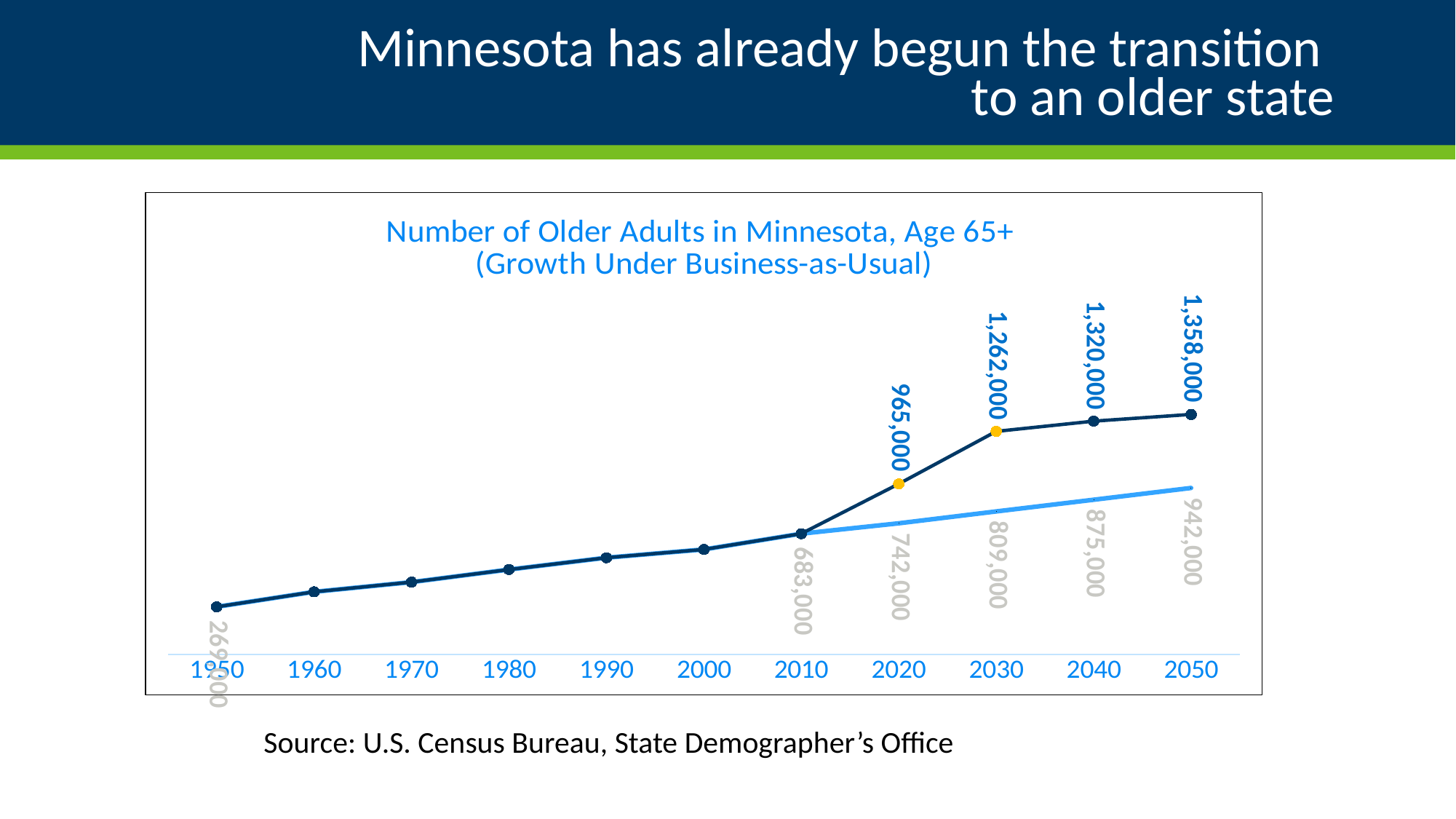
What is the number of older adults in Minnesota in 2010? 683,000 What value does the lower light blue line show for 2020? 742,000 What value does the lower light blue line show for 2050? 942,000 What value does the upper dark blue line show for 2050? 1,358,000 What is the chart's title? Number of Older Adults in Minnesota, Age 65+ (Growth Under Business-as-Usual) What is the number of older adults in Minnesota in 1950? 269,000 In 2020, how much higher is the upper dark blue line value than the lower light blue line value? 223,000 In 2050, what is the difference between the upper dark blue line value and the lower light blue line value? 416,000 Do the values on the upper dark blue line rise or fall from 1950 to 2050? rise What kind of chart is shown on the slide? line chart How many years are labelled on the x axis? 11 What value does the upper dark blue line show for 2030? 1,262,000